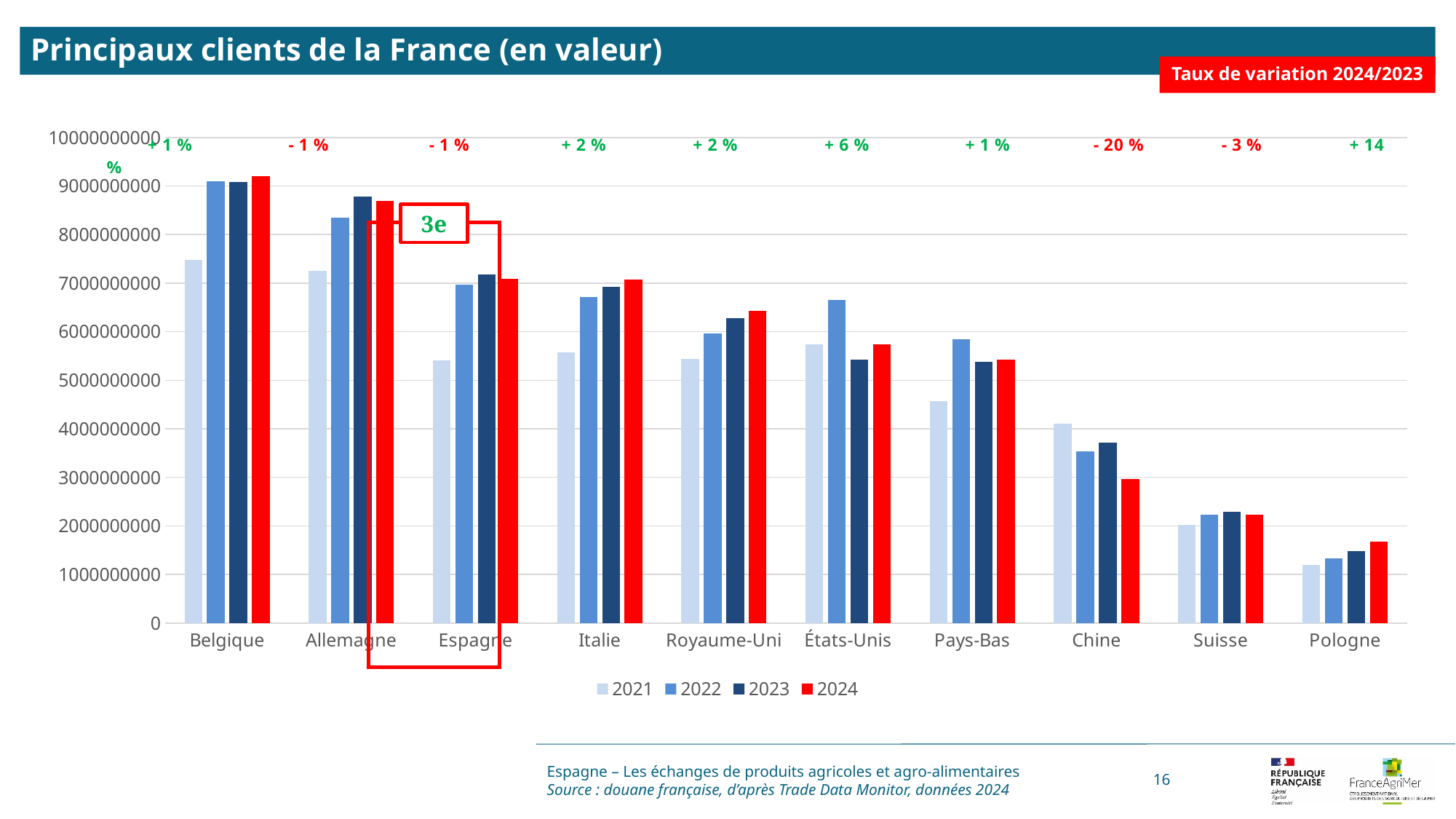
Which is larger, the 2024 value for Belgique or the 2024 value for Allemagne? Belgique Which country has the lowest 2024 value in the chart? Pologne Which country has the highest 2024 value in the chart? Belgique What is the title of the chart? Principaux clients de la France (en valeur) Do the 2024 values rise or fall moving from Belgique to Pologne along the x axis? fall Is the 2024 value for Belgique greater or less than 9000000000? greater How many series does the chart legend list? 4 What is the 2024/2023 variation rate printed above États-Unis? + 6 % Is the 2024 value for Chine greater or less than 4000000000? less How many countries are shown on the x axis of the chart? 10 What is the 2024/2023 variation rate printed above Chine? - 20 % What kind of chart is shown on the slide? bar chart